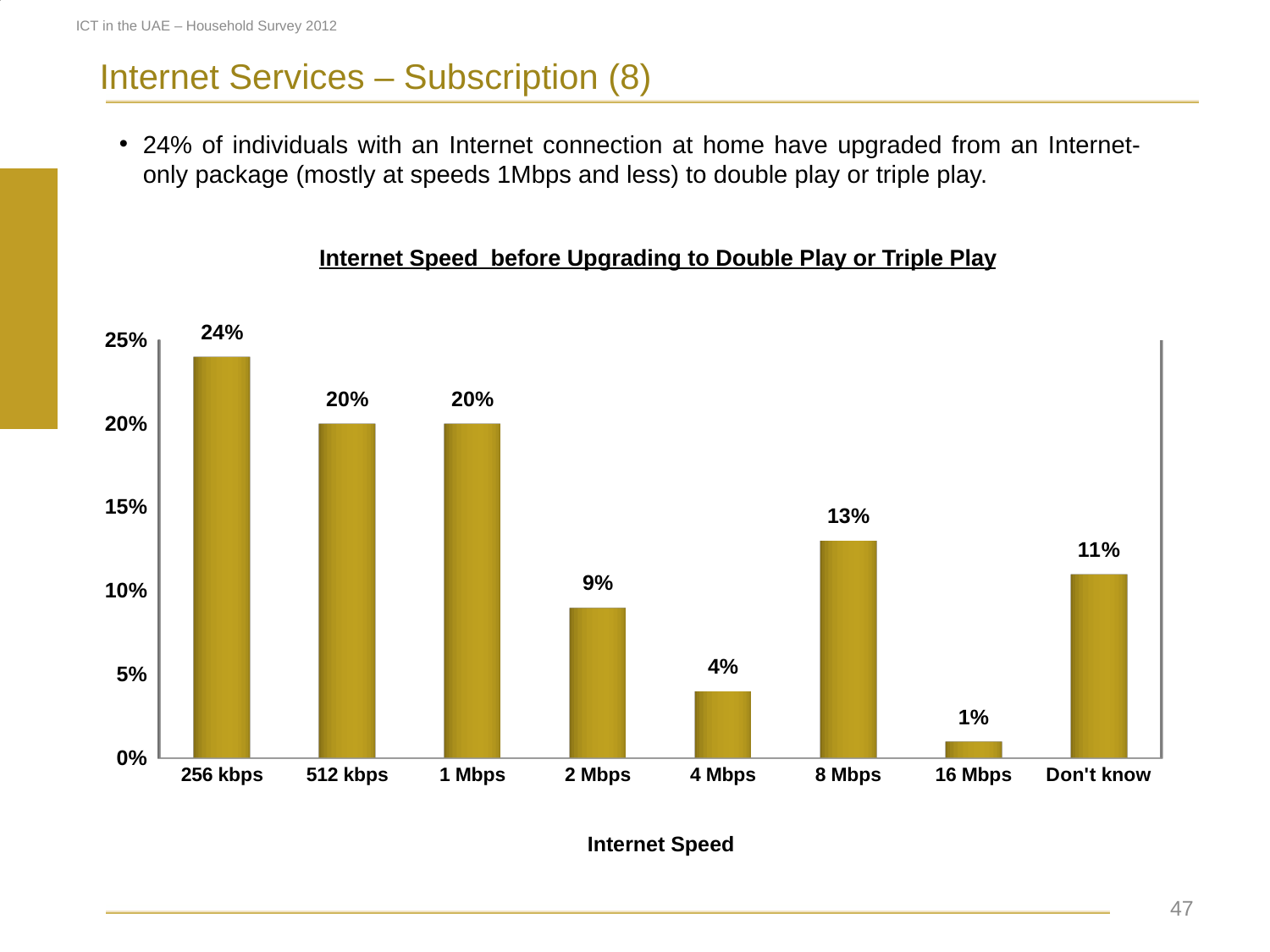
Is the value for 2 Mbps greater or less than 10%? less What percentage of respondents had an Internet speed of 256 kbps before upgrading to double play or triple play? 24% What kind of chart is used to show Internet speed before upgrading? Bar chart What percentage answered 'Don't know' about their Internet speed before upgrading? 11% What is the title of the chart on the slide? Internet Speed before Upgrading to Double Play or Triple Play How many Internet speed categories are shown on the x axis of the chart? 8 Which has a larger value, 8 Mbps or Don't know? 8 Mbps Which Internet speed category has the highest value in the chart? 256 kbps What is the value shown for 8 Mbps in the chart? 13% What is the difference between the values for 8 Mbps and 4 Mbps? 9% What is the difference between the values for 256 kbps and 2 Mbps? 15% Which Internet speed category has the lowest value in the chart? 16 Mbps